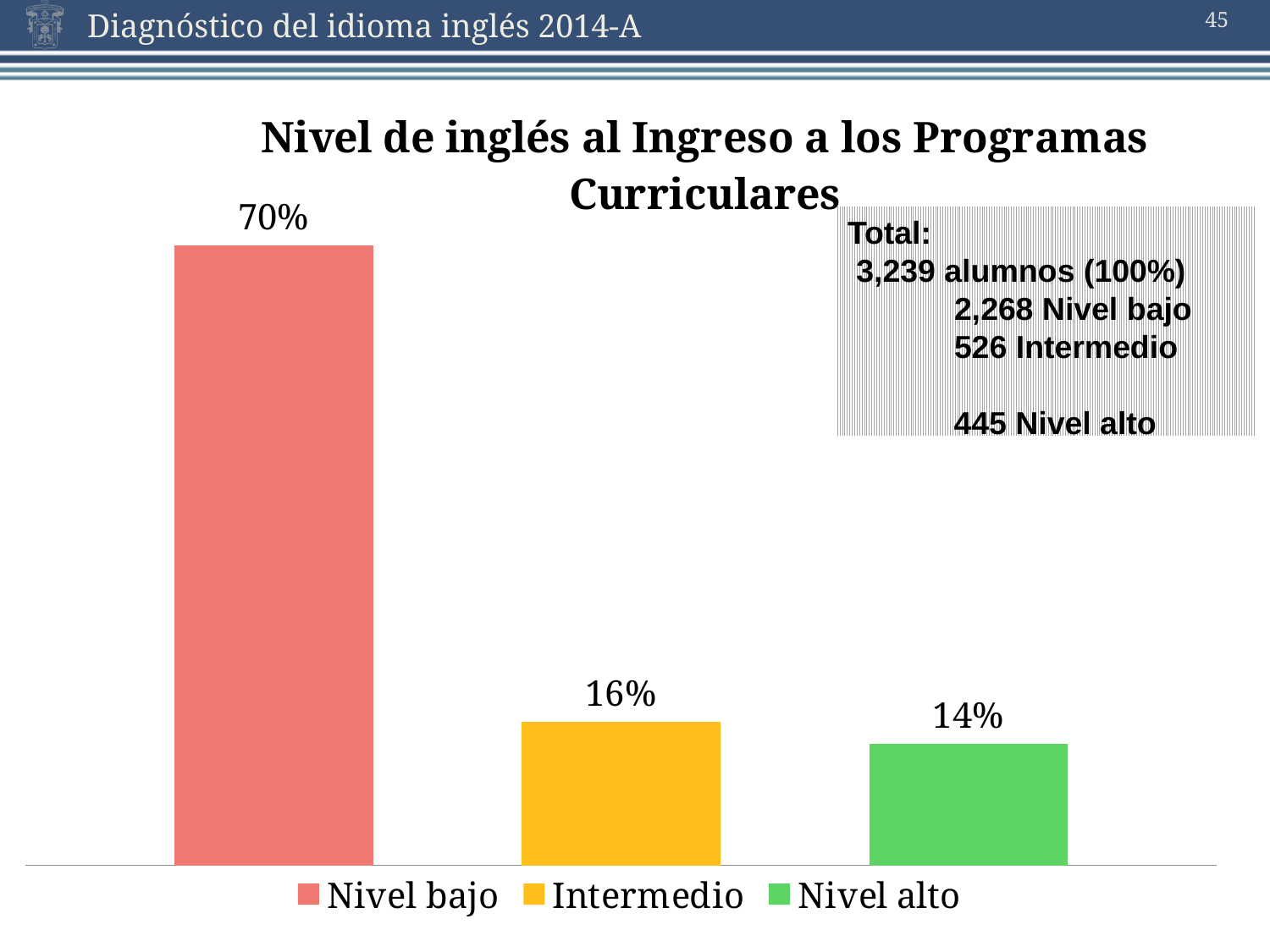
What is the title of the chart? Nivel de inglés al Ingreso a los Programas Curriculares Which is larger, the value for Nivel bajo or the value for Nivel alto? Nivel bajo How many bars are shown in the chart? 3 What kind of chart is shown on the slide? Bar chart What is the difference between the values for Nivel bajo and Intermedio? 54% What is the value for Nivel bajo? 70% Which category has the highest value? Nivel bajo What is the value for Nivel alto? 14% Which category has the lowest value? Nivel alto How many entries does the legend list? 3 What is the value for Intermedio? 16% What is the difference between the values for Intermedio and Nivel alto? 2%